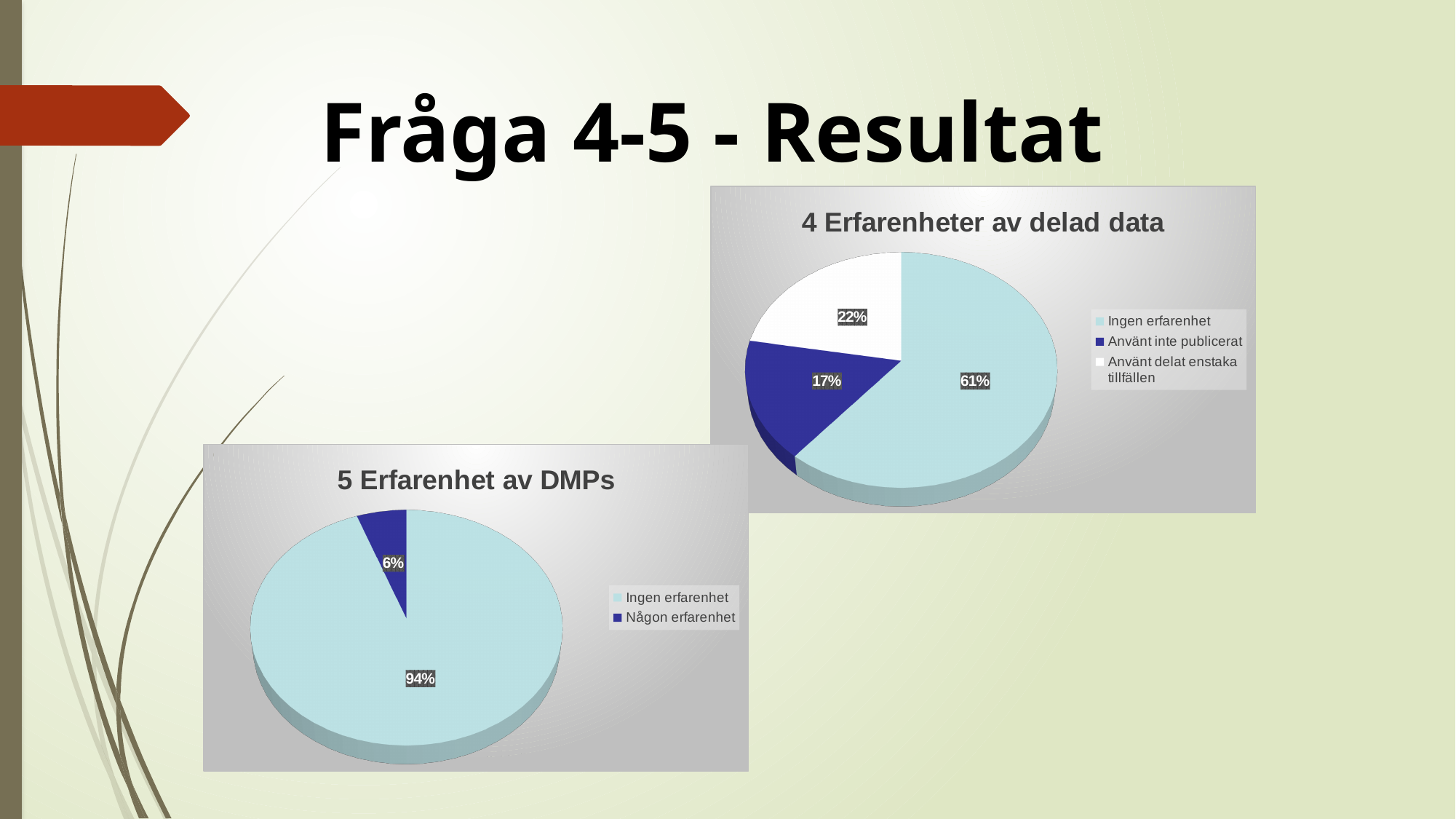
In the chart titled "4 Erfarenheter av delad data", what share does "Ingen erfarenhet" have? 61% In the chart titled "4 Erfarenheter av delad data", what share does "Använt delat enstaka tillfällen" have? 22% In the chart titled "5 Erfarenhet av DMPs", what colour is the "Någon erfarenhet" slice? Dark blue In the chart titled "4 Erfarenheter av delad data", what share does "Använt inte publicerat" have? 17% In the chart titled "4 Erfarenheter av delad data", what is the difference in percentage points between "Ingen erfarenhet" and "Använt delat enstaka tillfällen"? 39 In the chart titled "4 Erfarenheter av delad data", how many categories does the legend list? 3 In the chart titled "4 Erfarenheter av delad data", which category has the largest slice? Ingen erfarenhet In the chart titled "5 Erfarenhet av DMPs", what share does "Ingen erfarenhet" have? 94% In the chart titled "5 Erfarenhet av DMPs", what share does "Någon erfarenhet" have? 6% What kind of chart is "5 Erfarenhet av DMPs"? Pie chart In the chart titled "5 Erfarenhet av DMPs", which category is larger, "Ingen erfarenhet" or "Någon erfarenhet"? Ingen erfarenhet In the chart titled "4 Erfarenheter av delad data", which category has the smallest slice? Använt inte publicerat